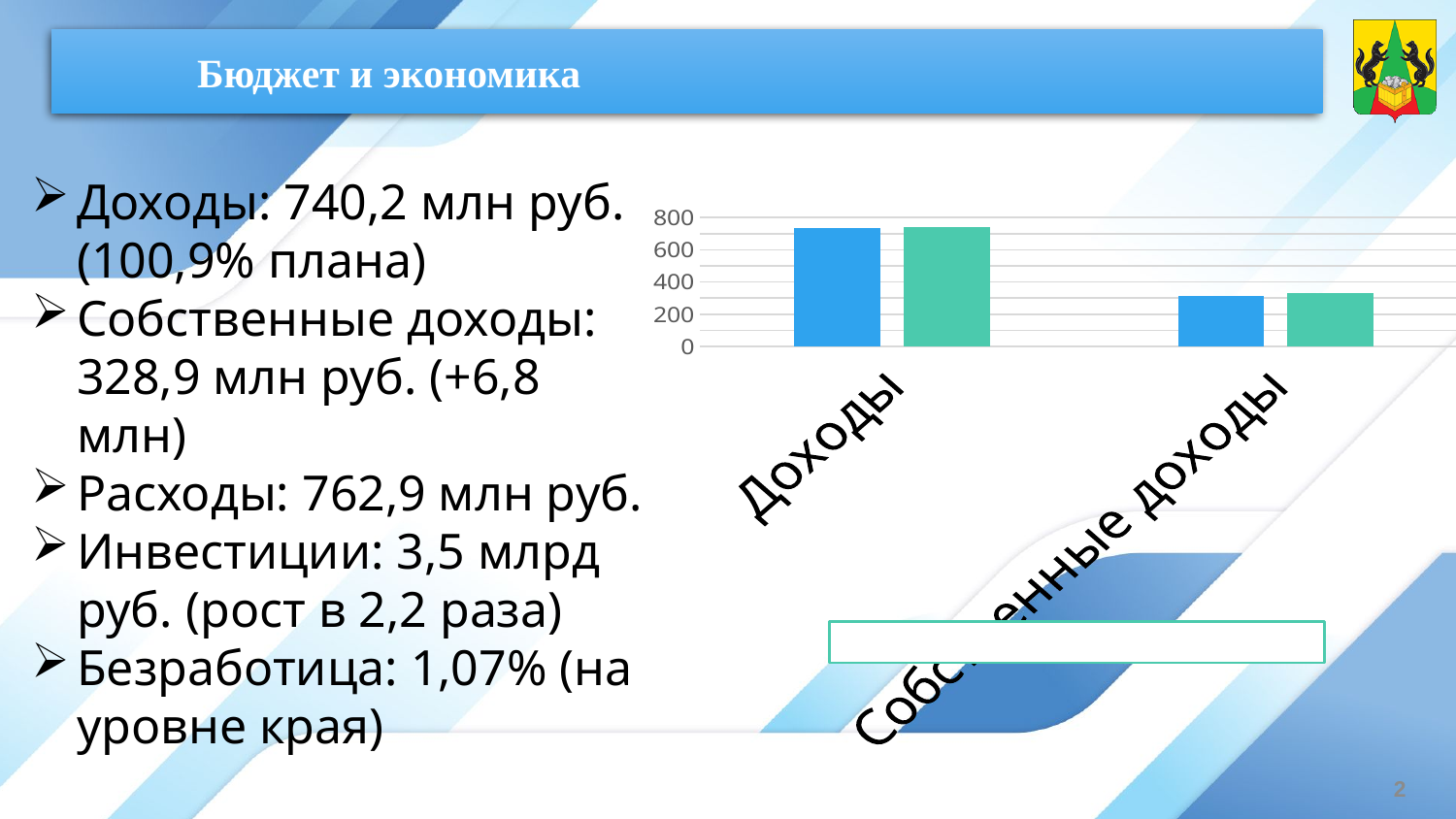
Which category has the lowest bars in the chart? Собственные доходы Is the value of the green bar for Собственные доходы greater or less than 400? less What kind of chart is shown on the slide? bar chart How many categories are shown on the x axis of the chart? 2 How many bars are plotted for the category Доходы? 2 Which category has larger values, Доходы or Собственные доходы? Доходы What is the highest tick value shown on the chart's vertical axis? 800 Is the value of the blue bar for Доходы greater or less than 600? greater Is the value of the blue bar for Собственные доходы greater or less than 200? greater Which category has the highest bars in the chart? Доходы What two colours are used for the bars in the chart? blue and green